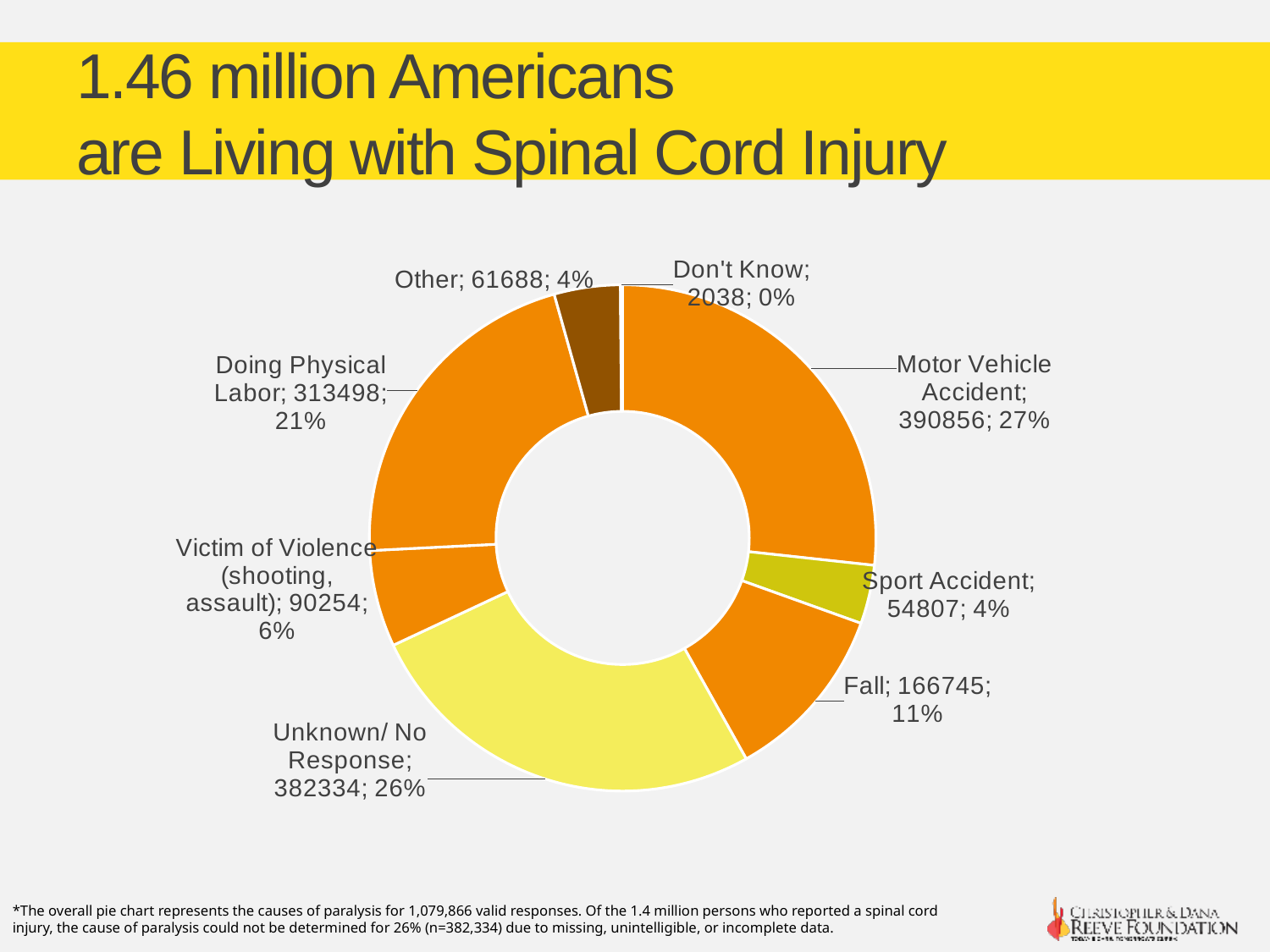
What is the value for Doing Physical Labor? 313498 What kind of chart is shown on the slide? doughnut chart What share of the pie does Victim of Violence (shooting, assault) represent? 6% Which is larger, the value for Doing Physical Labor or the value for Fall? Doing Physical Labor What is the difference between the values for Fall and Sport Accident? 111938 How many categories does the pie chart show? 8 What is the value for Fall? 166745 Which category has the smallest value? Don't Know Which category has the largest value? Motor Vehicle Accident What is the value for Motor Vehicle Accident? 390856 What is the difference between the values for Motor Vehicle Accident and Unknown/ No Response? 8522 What share of the pie does Unknown/ No Response represent? 26%